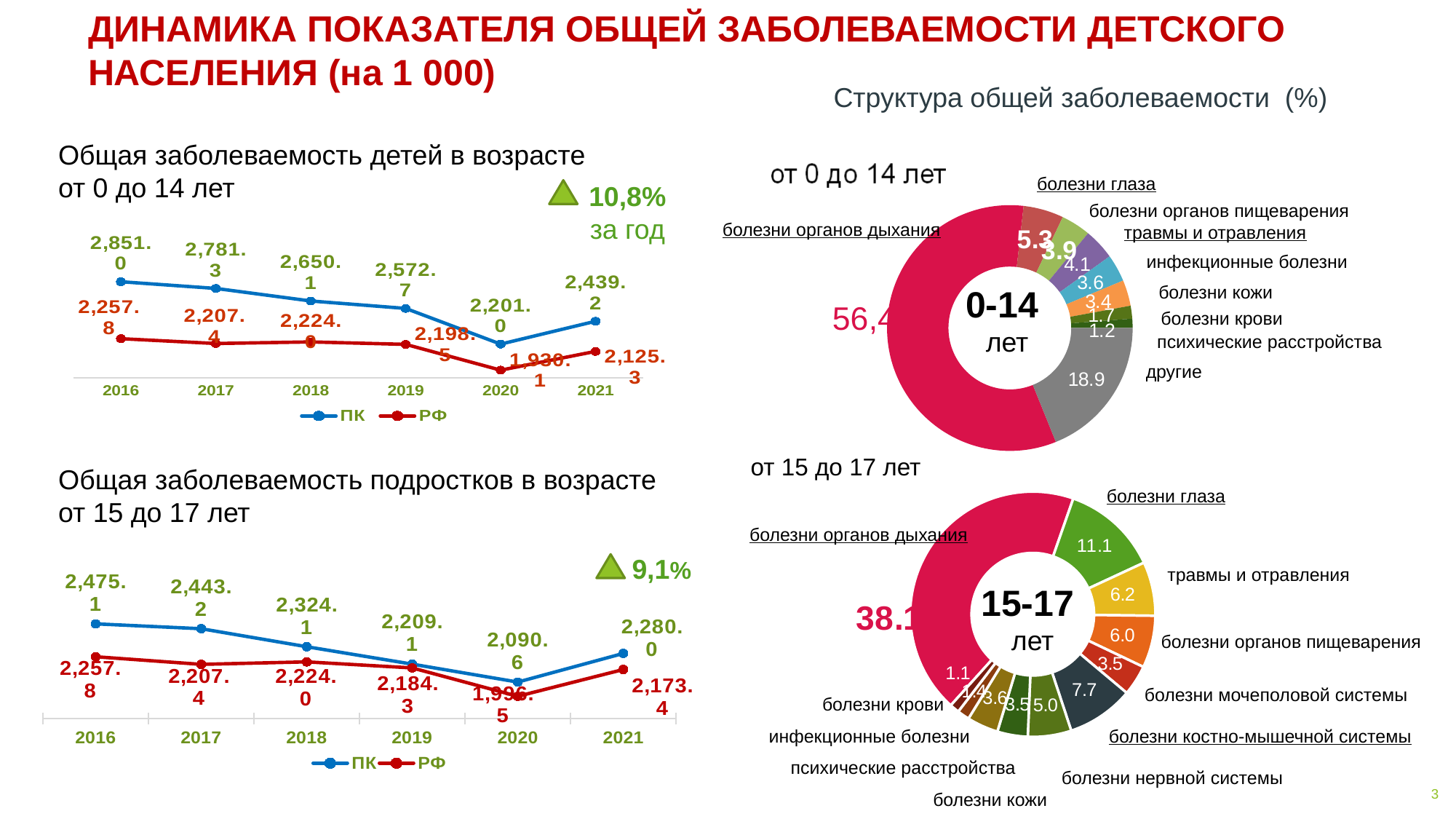
On the line chart for adolescents aged 15 to 17 (Общая заболеваемость подростков в возрасте от 15 до 17 лет), what is the ПК value for 2021? 2,280.0 On the line chart for children aged 0 to 14 (Общая заболеваемость детей в возрасте от 0 до 14 лет), what is the ПК value for 2016? 2,851.0 On the line chart for adolescents aged 15 to 17, which is larger in 2018, the ПК value or the РФ value? ПК On the line chart for adolescents aged 15 to 17, what is the РФ value for 2019? 2,184.3 What type of chart is used to show the structure of overall morbidity for ages 0 to 14 (от 0 до 14 лет)? Donut (pie) chart On the line chart for children aged 0 to 14, in which year is the ПК value lowest? 2020 On the line chart for adolescents aged 15 to 17, how many years are shown on the x axis? 6 On the donut chart for ages 0 to 14, what is the share for болезни глаза? 5.3 On the line chart for children aged 0 to 14, what is the difference between the ПК and РФ values in 2021? 313.9 On the line chart for children aged 0 to 14, what is the РФ value for 2020? 1,930.1 On the line chart for children aged 0 to 14, how many series does the legend list? 2 On the donut chart for ages 15 to 17, what is the share for болезни костно-мышечной системы? 7.7